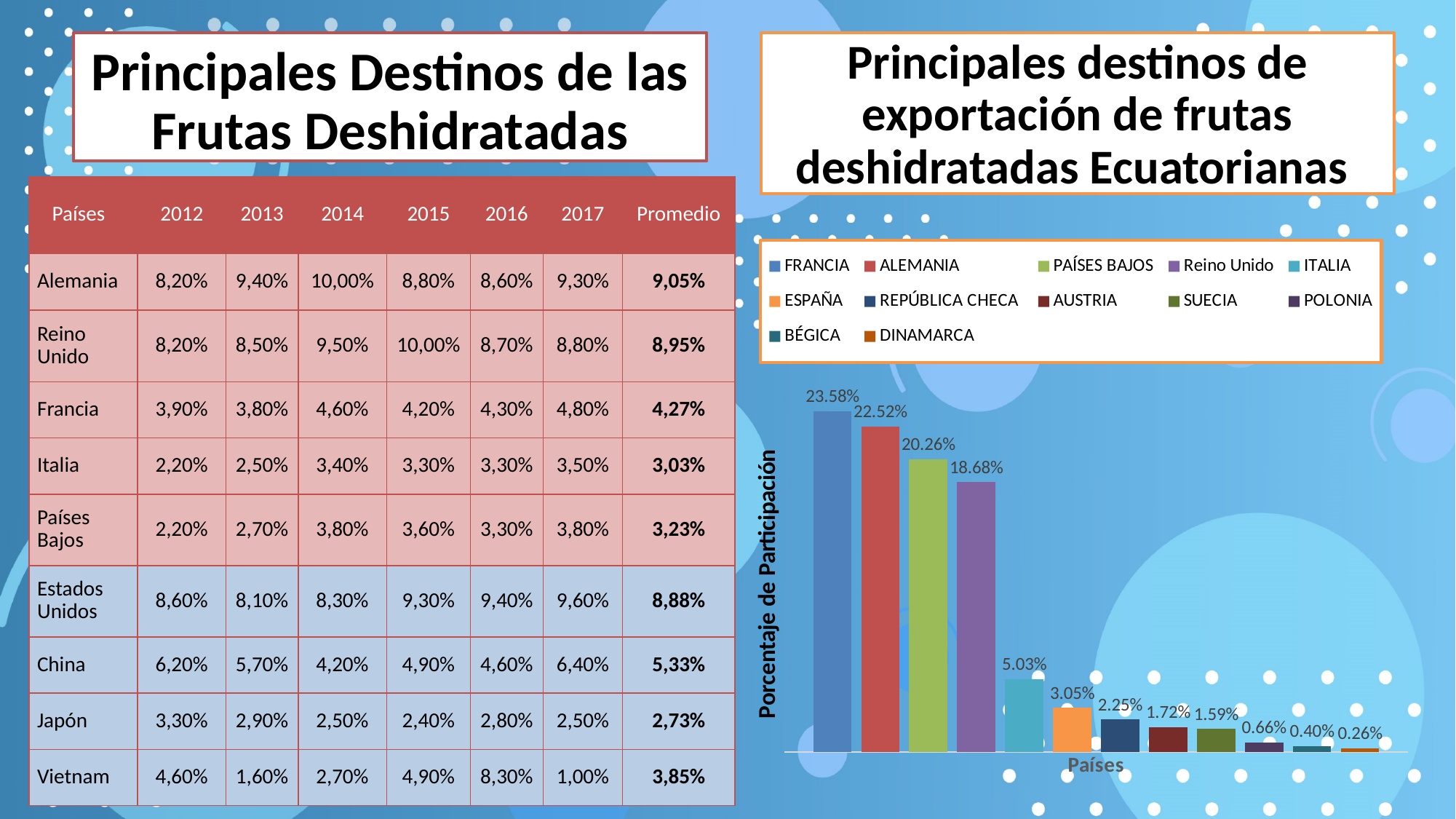
How many bars are plotted in the bar chart? 12 In the bar chart, what is the difference between the values for PAÍSES BAJOS and Reino Unido? 1.58% In the bar chart, what is the value shown for ITALIA? 5.03% What kind of chart is shown on the right side of the slide? Bar chart In the bar chart, which country has the lowest value? DINAMARCA In the bar chart, what is the value shown for FRANCIA? 23.58% In the bar chart, what is the difference between the values for FRANCIA and ALEMANIA? 1.06% In the bar chart, which country has the highest value? FRANCIA In the bar chart, which is larger, the value for ESPAÑA or the value for AUSTRIA? ESPAÑA What is the label of the vertical axis of the bar chart? Porcentaje de Participación How many entries does the legend of the bar chart list? 12 In the bar chart, what is the value shown for REPÚBLICA CHECA? 2.25%